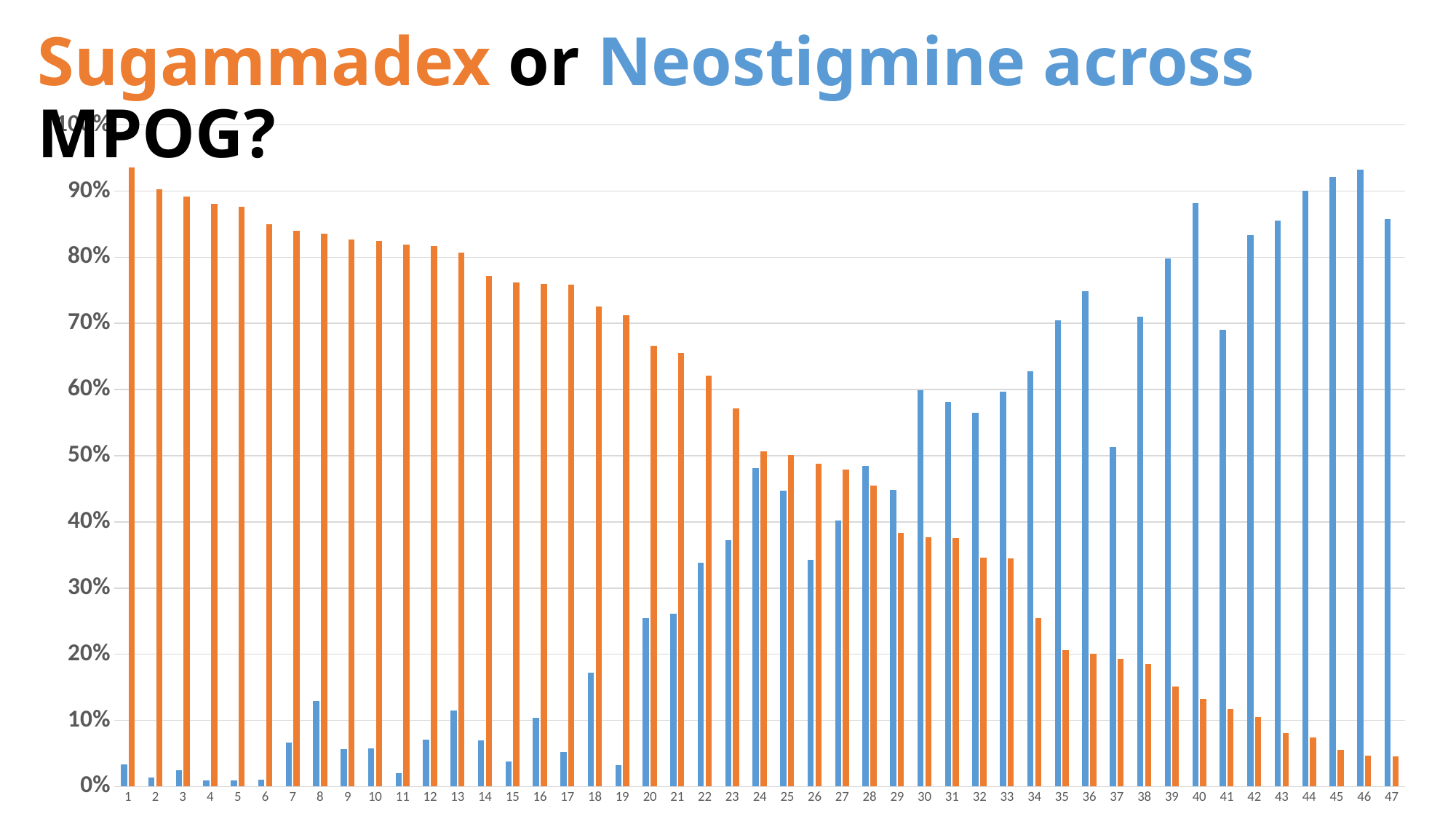
Which colour represents Sugammadex in the chart? orange Is the Sugammadex value for category 20 greater or less than 60%? greater How many categories are shown along the x axis? 47 For category 10, which is larger, the Sugammadex value or the Neostigmine value? Sugammadex Is the Sugammadex value for category 1 greater or less than 90%? greater For category 30, which is larger, the Sugammadex value or the Neostigmine value? Neostigmine Which colour represents Neostigmine in the chart? blue Is the Sugammadex value for category 47 greater or less than 10%? less What kind of chart is shown on the slide? bar chart Do the Sugammadex values generally rise or fall from category 1 to category 47? fall